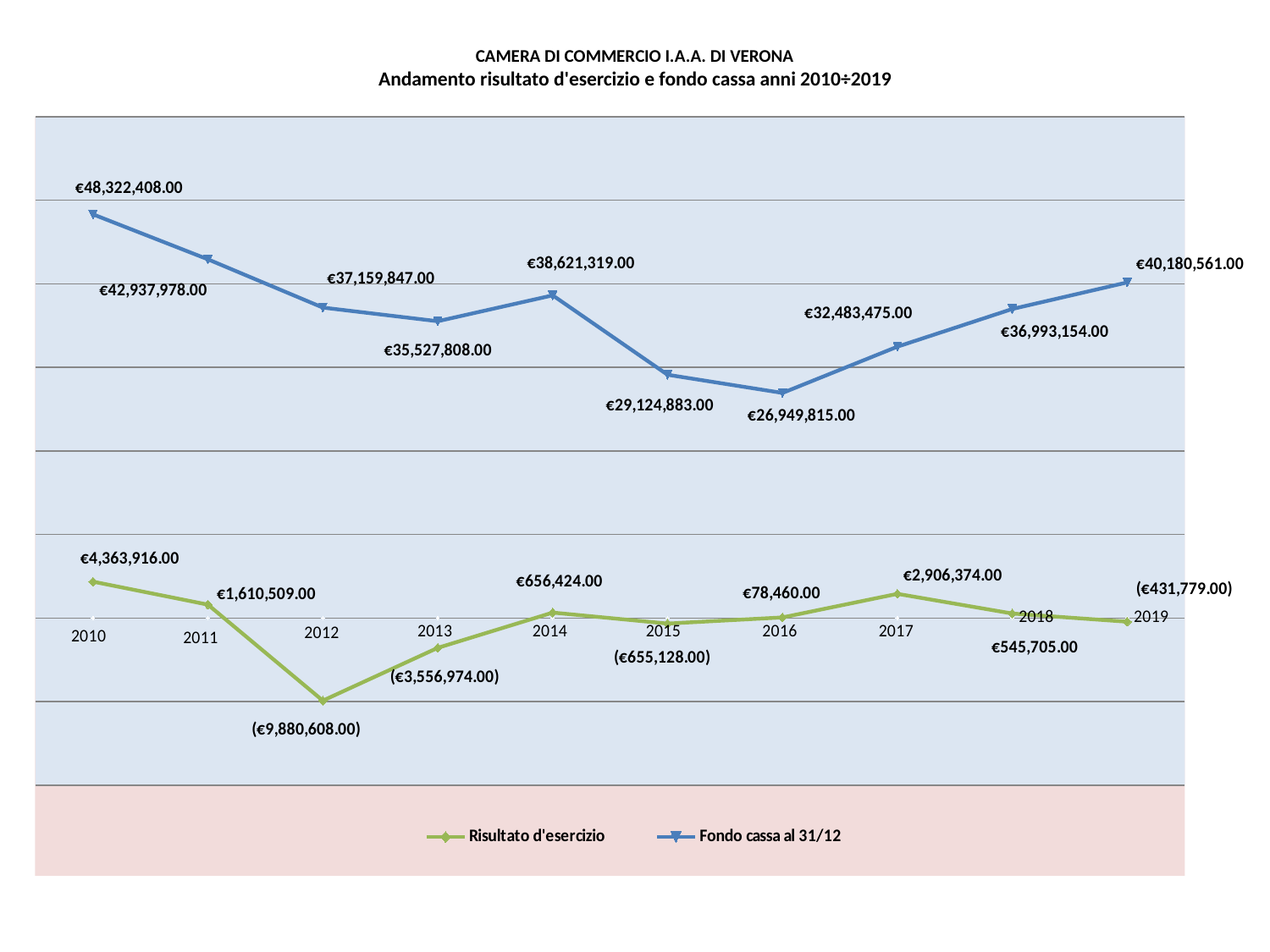
What is the Fondo cassa al 31/12 value for 2010? €48,322,408.00 In which year is the Fondo cassa al 31/12 lowest? 2016 What is the Fondo cassa al 31/12 value for 2019? €40,180,561.00 How many years are shown on the x axis? 10 Which year has the larger Fondo cassa al 31/12, 2014 or 2015? 2014 In which year is the Risultato d'esercizio highest? 2010 What kind of chart is shown on the slide? Line chart Does the Fondo cassa al 31/12 rise or fall from 2016 to 2019? Rise What is the Risultato d'esercizio value for 2017? €2,906,374.00 What is the difference between the Fondo cassa al 31/12 in 2010 and in 2019? €8,141,847.00 How many series does the legend list? 2 What is the Risultato d'esercizio value for 2012? (€9,880,608.00)